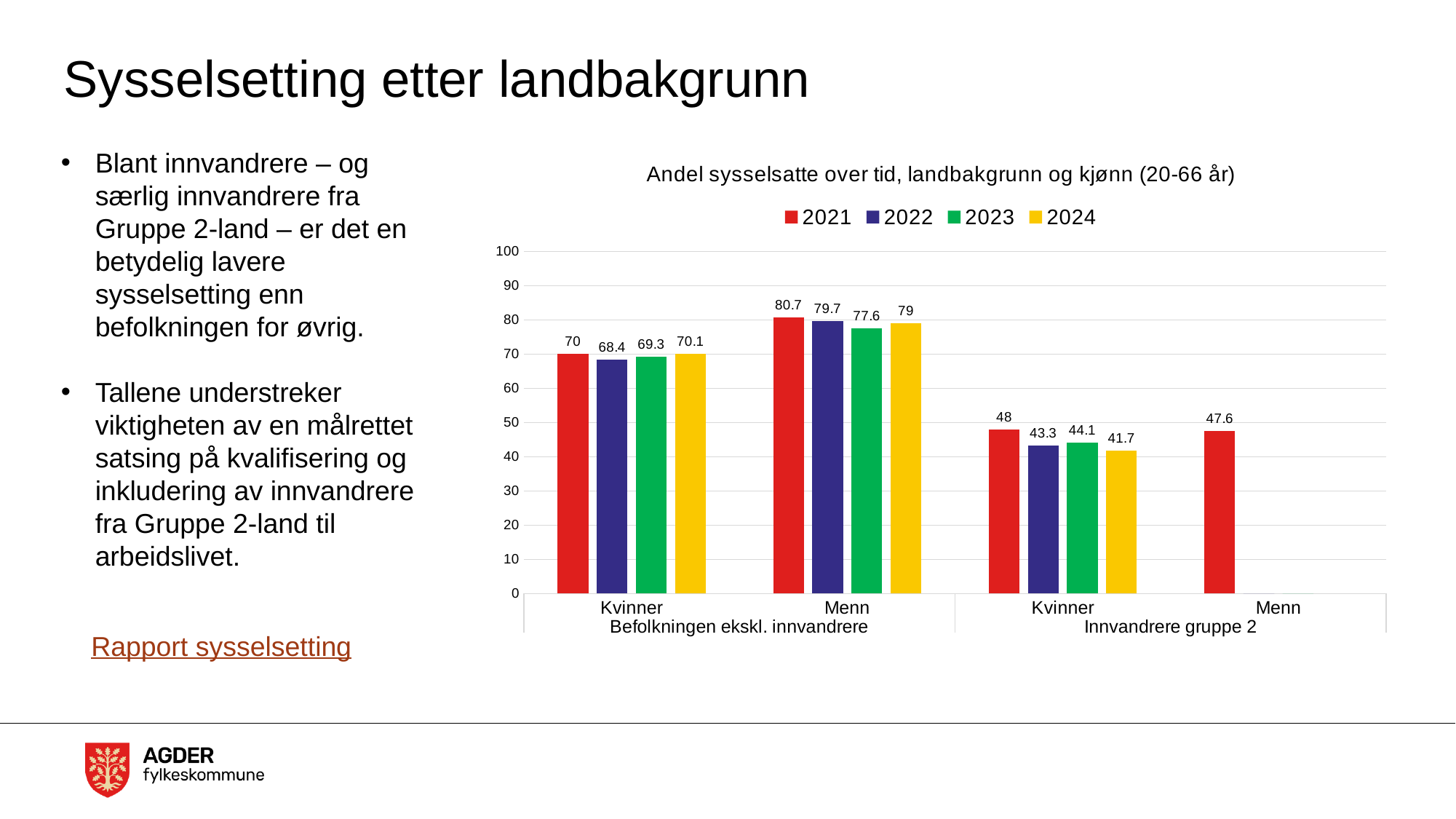
What is the difference between the 2021 values for Menn in Befolkningen ekskl. innvandrere and Menn in Innvandrere gruppe 2? 33.1 What is the title of the chart? Andel sysselsatte over tid, landbakgrunn og kjønn (20-66 år) Is the 2023 value for Menn in Befolkningen ekskl. innvandrere greater or less than 70? greater What is the 2021 value for Menn in Befolkningen ekskl. innvandrere? 80.7 What is the 2021 value for Menn in Innvandrere gruppe 2? 47.6 Which year has the lowest value for Kvinner in Innvandrere gruppe 2? 2024 Which year has the highest value for Menn in Befolkningen ekskl. innvandrere? 2021 What is the 2024 value for Kvinner in Innvandrere gruppe 2? 41.7 Which is larger: the 2022 value for Kvinner in Befolkningen ekskl. innvandrere or the 2022 value for Kvinner in Innvandrere gruppe 2? Kvinner in Befolkningen ekskl. innvandrere How many series does the legend list? 4 What kind of chart is shown on the slide? Bar chart What is the 2023 value for Kvinner in Befolkningen ekskl. innvandrere? 69.3